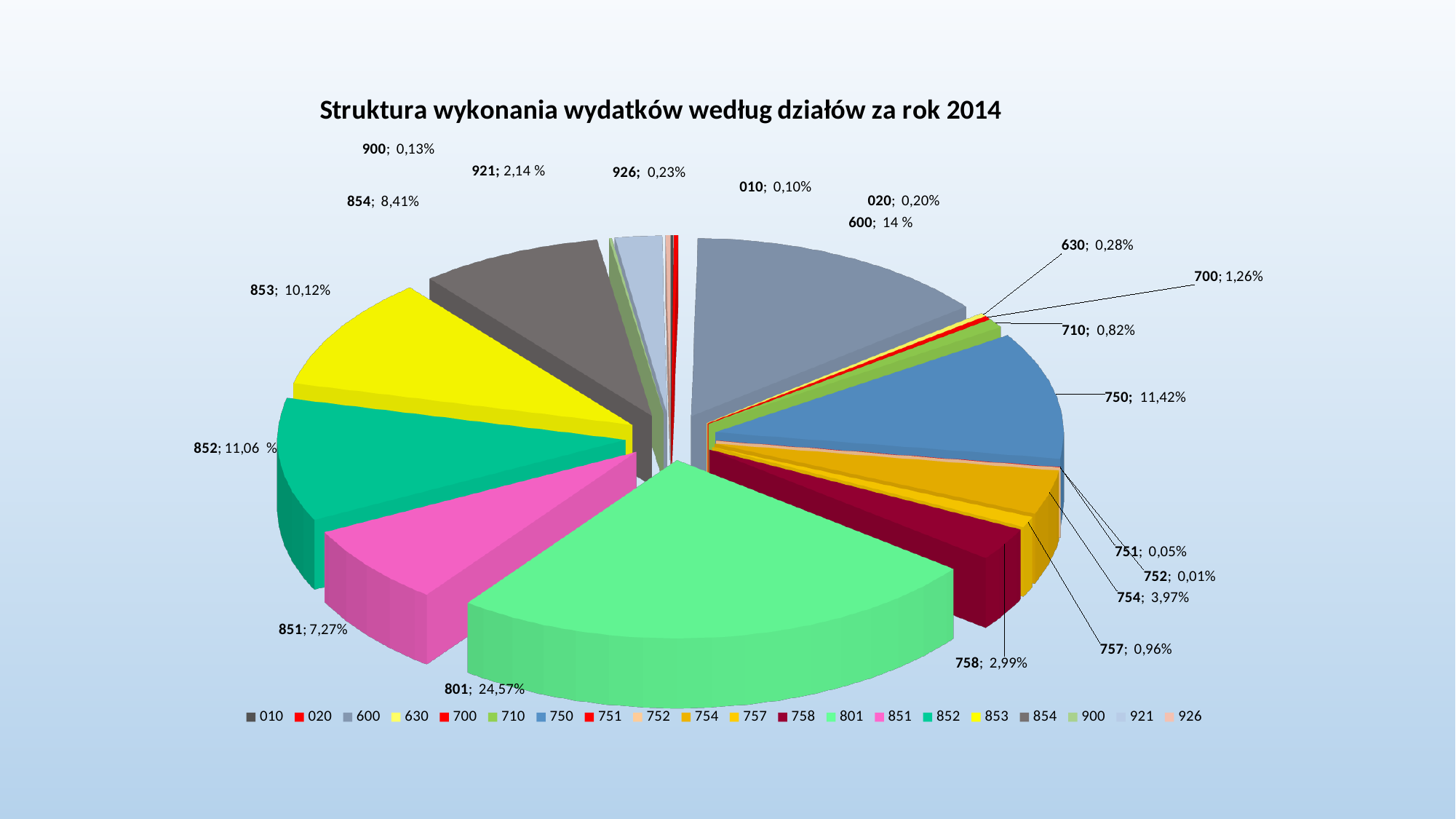
What type of chart is shown on the slide? pie chart What is the value shown for category 854? 8,41% How many categories does the legend list? 20 Which category has the smallest slice of the pie? 752 What is the value shown for category 750? 11,42% Which has the larger share, category 750 or category 852? 750 What is the title of the chart? Struktura wykonania wydatków według działów za rok 2014 Which category has the largest slice of the pie? 801 What is the difference in percentage points between category 801 and category 600? 10,57 What is the value shown for category 600? 14 % What is the difference in percentage points between category 853 and category 854? 1,71 What share of the pie does category 801 have? 24,57%